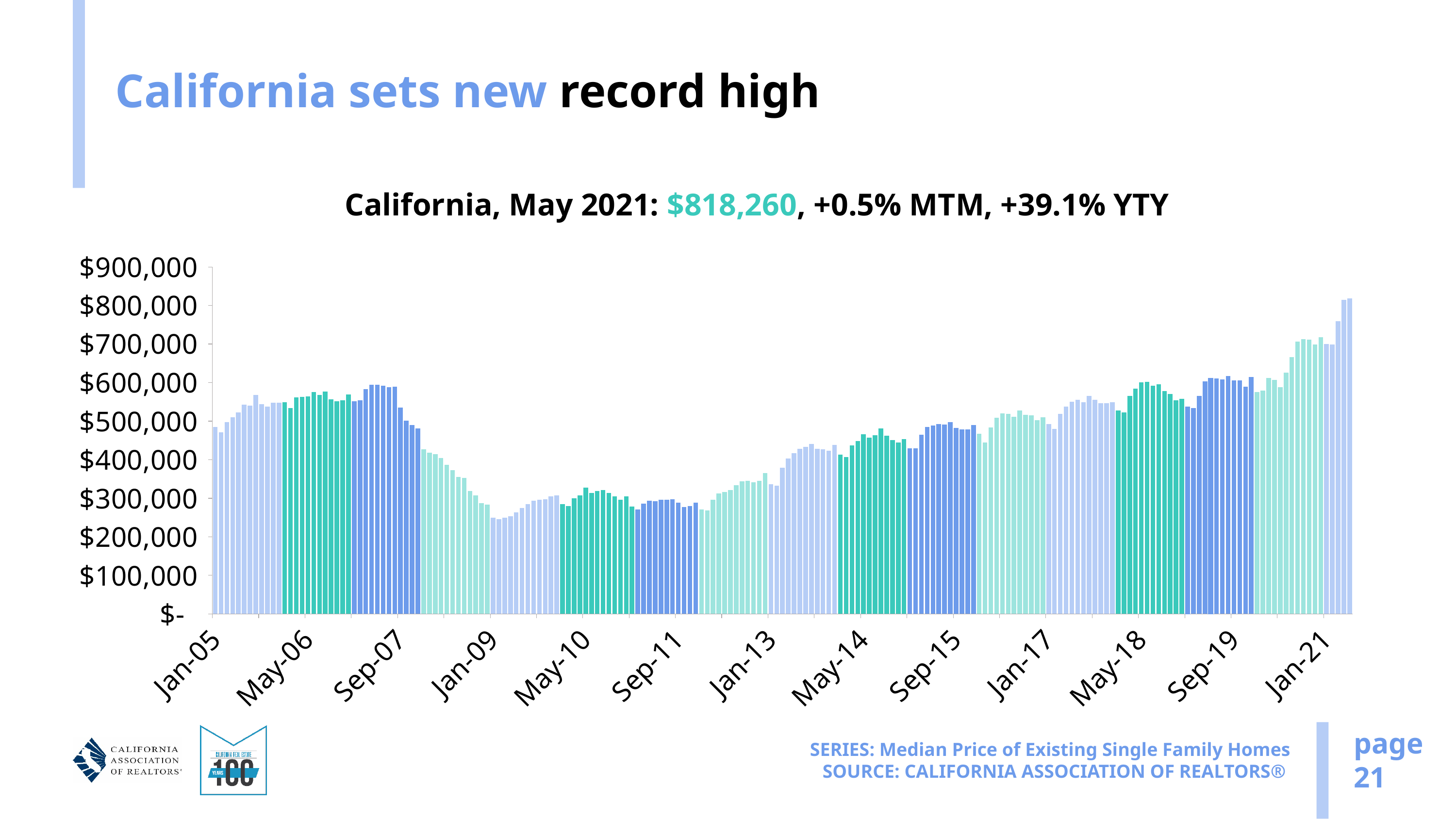
What year-to-year (YTY) change is stated in the chart title? +39.1% Which month has the highest bar in the chart? May 2021 Which is larger, the value for Sep-07 or the value for Sep-11? Sep-07 What is the California median price for May 2021 shown in the chart title? $818,260 Do the values rise or fall between Sep-07 and Jan-09? fall Is the value for Jan-05 greater or less than $400,000? greater What month-to-month (MTM) change is stated in the chart title? +0.5% Is the value for Jan-21 greater or less than $600,000? greater Which is larger, the value for Jan-05 or the value for Jan-09? Jan-05 Is the value for Jan-09 greater or less than $300,000? less What kind of chart is shown on the slide? bar chart